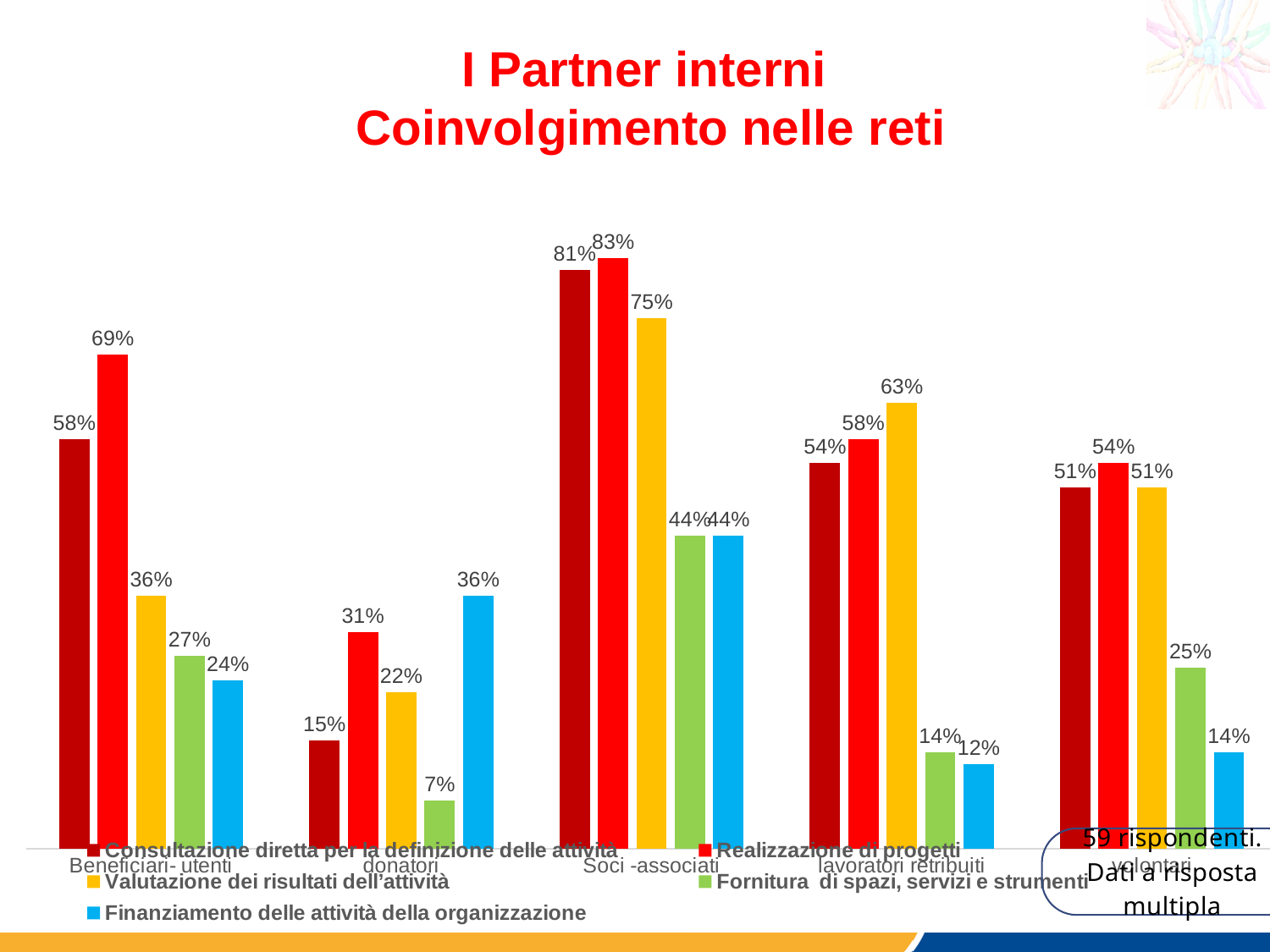
Which category has the lowest value for Fornitura di spazi, servizi e strumenti? donatori How many categories are shown on the x axis? 5 What is the value for Realizzazione di progetti in the Soci -associati category? 83% What is the value for Fornitura di spazi, servizi e strumenti in the Beneficiari- utenti category? 27% What is the value for Finanziamento delle attività della organizzazione in the donatori category? 36% How many series does the legend list? 5 Which category has the highest value for Consultazione diretta per la definizione delle attività? Soci -associati What kind of chart is shown on the slide? bar chart Which is larger in the lavoratori retribuiti category: Valutazione dei risultati dell'attività or Realizzazione di progetti? Valutazione dei risultati dell'attività What colour are the bars for Finanziamento delle attività della organizzazione? blue What is the difference between the Realizzazione di progetti value and the Consultazione diretta value in the Beneficiari- utenti category? 11% What is the value for Valutazione dei risultati dell'attività in the lavoratori retribuiti category? 63%